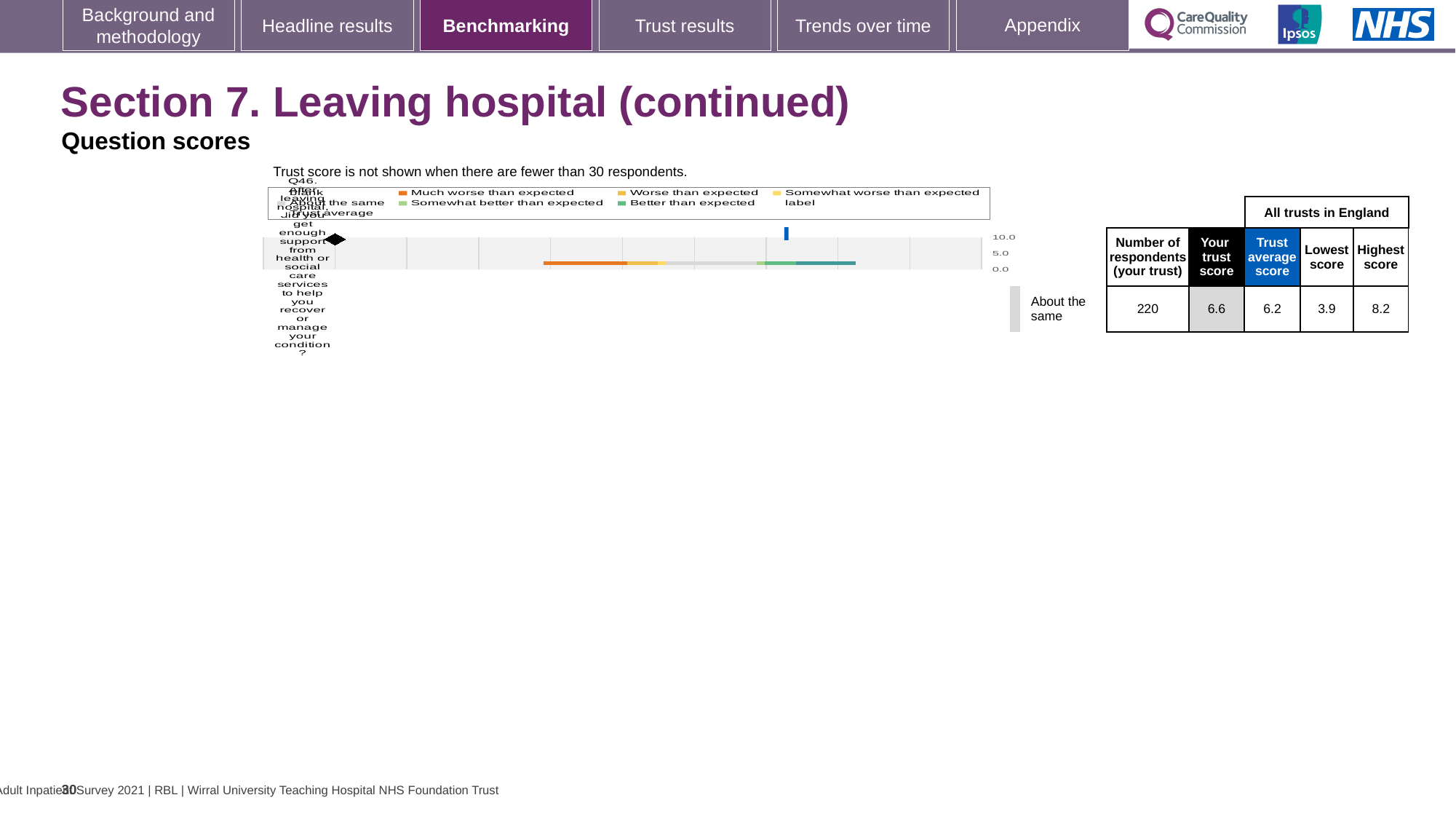
What colour represents 'Much worse than expected' in the chart legend? Orange What is the maximum value shown on the chart's score axis? 10.0 How many respondents from the trust answered Q46? 220 What is the trust average score for Q46 across all trusts in England? 6.2 What is the lowest score among all trusts in England for Q46? 3.9 What is the highest score among all trusts in England for Q46? 8.2 What is the difference between the highest and lowest scores among all trusts in England for Q46? 4.3 What is the difference between the trust's score and the trust average score for Q46? 0.4 Is the trust's score for Q46 greater or less than 5.0 on the chart axis? greater What benchmark category is the trust's Q46 result assigned to on the slide? About the same What is the trust score for Q46 shown in the table next to the chart? 6.6 Which is larger for Q46: the trust's score or the trust average score? The trust's score